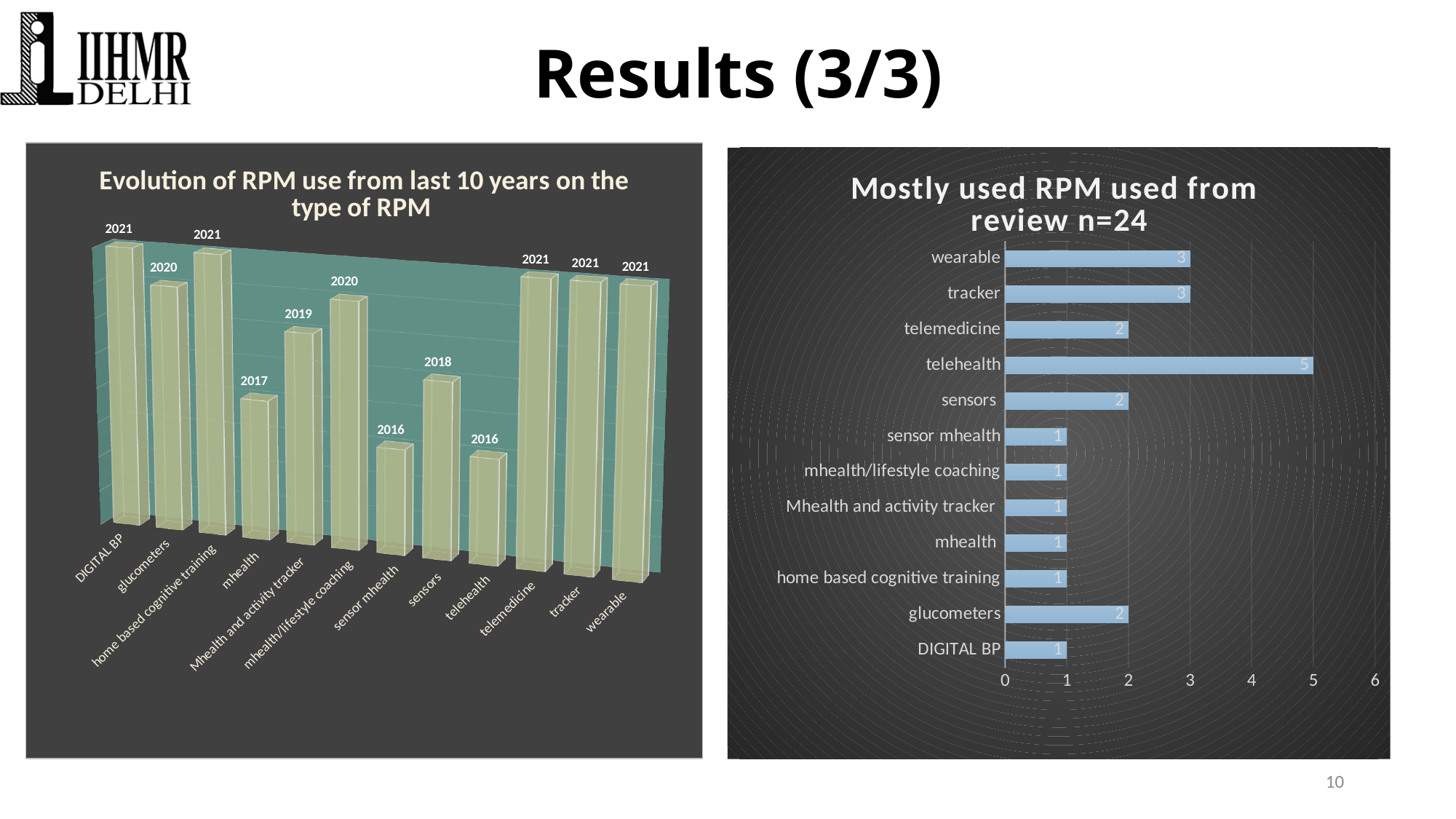
In the 'Mostly used RPM used from review n=24' chart, what is the highest value shown on the horizontal axis? 6 In the 'Evolution of RPM use from last 10 years on the type of RPM' chart, what is the label shown for sensors? 2018 What type of chart is the 'Evolution of RPM use from last 10 years on the type of RPM' chart? bar chart In the 'Mostly used RPM used from review n=24' chart, which category has the highest value? telehealth In the 'Mostly used RPM used from review n=24' chart, how many categories are shown? 12 In the 'Mostly used RPM used from review n=24' chart, what is the value for telehealth? 5 In the 'Evolution of RPM use from last 10 years on the type of RPM' chart, what is the label shown for mhealth? 2017 In the 'Mostly used RPM used from review n=24' chart, what is the value for glucometers? 2 What type of chart is the 'Mostly used RPM used from review n=24' chart? bar chart In the 'Evolution of RPM use from last 10 years on the type of RPM' chart, how many categories are shown? 12 In the 'Mostly used RPM used from review n=24' chart, which is larger, the value for tracker or the value for sensors? tracker In the 'Mostly used RPM used from review n=24' chart, what is the difference between the values for telehealth and wearable? 2